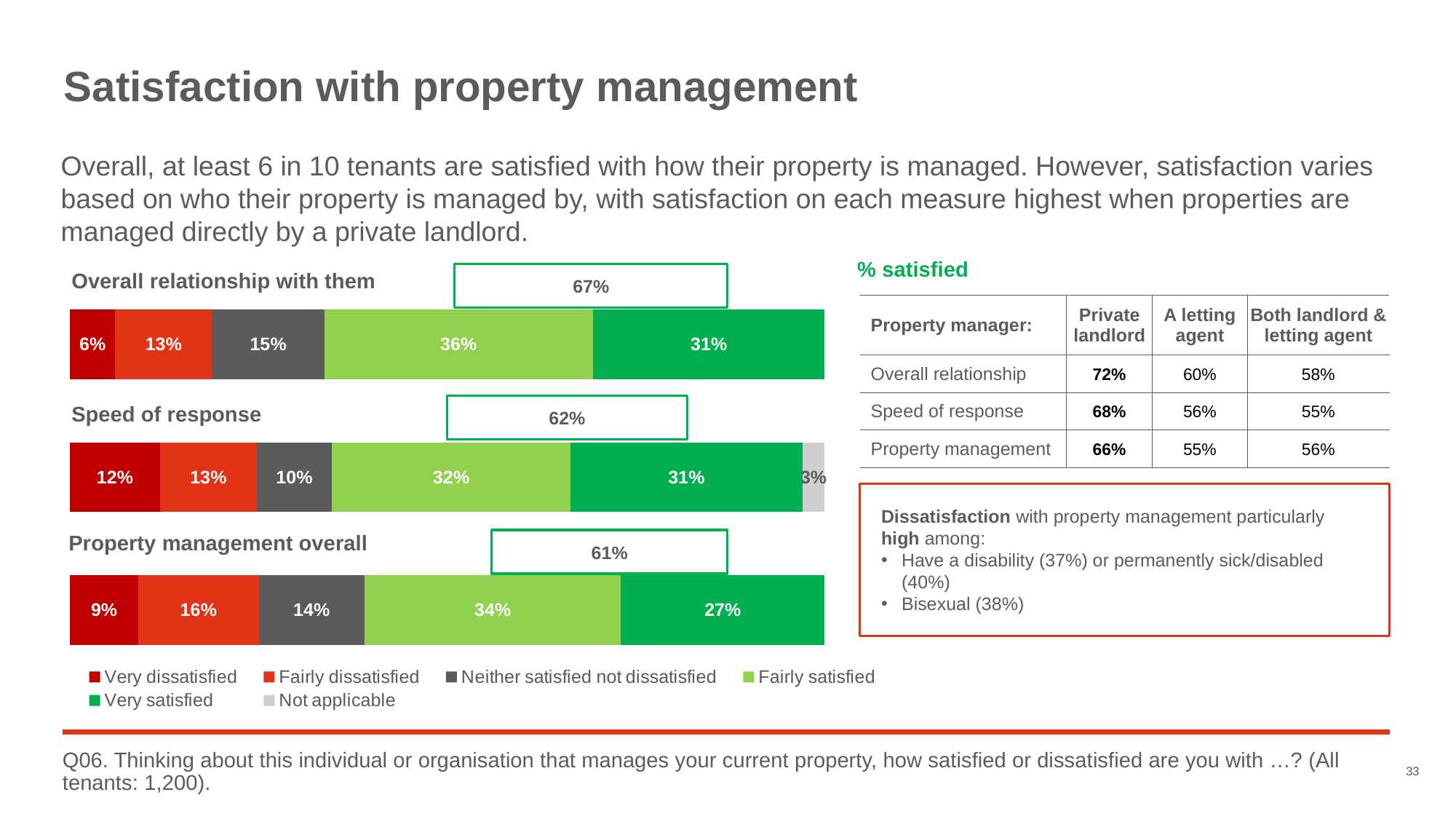
In the stacked bar chart, what percentage of tenants are very dissatisfied with speed of response? 12% How many series does the legend of the stacked bar chart list? 6 In the stacked bar chart, what is the combined very dissatisfied and fairly dissatisfied percentage for 'Property management overall'? 25% Which measure in the stacked bar chart has the lowest very dissatisfied percentage? Overall relationship with them How many measures (bars) are shown in the stacked bar chart? 3 What type of chart is used to show satisfaction with property management? Stacked bar chart In the stacked bar chart, what is the fairly satisfied value for 'Overall relationship with them'? 36% Which measure in the stacked bar chart has the highest fairly dissatisfied percentage? Property management overall In the stacked bar chart, how many percentage points higher is the fairly satisfied value for 'Overall relationship with them' than for 'Speed of response'? 4 percentage points In the stacked bar chart, what percentage of tenants are very satisfied with property management overall? 27% In the stacked bar chart, which has the larger very satisfied share: 'Overall relationship with them' or 'Property management overall'? Overall relationship with them What is the boxed overall satisfied percentage shown above the 'Speed of response' bar? 62%